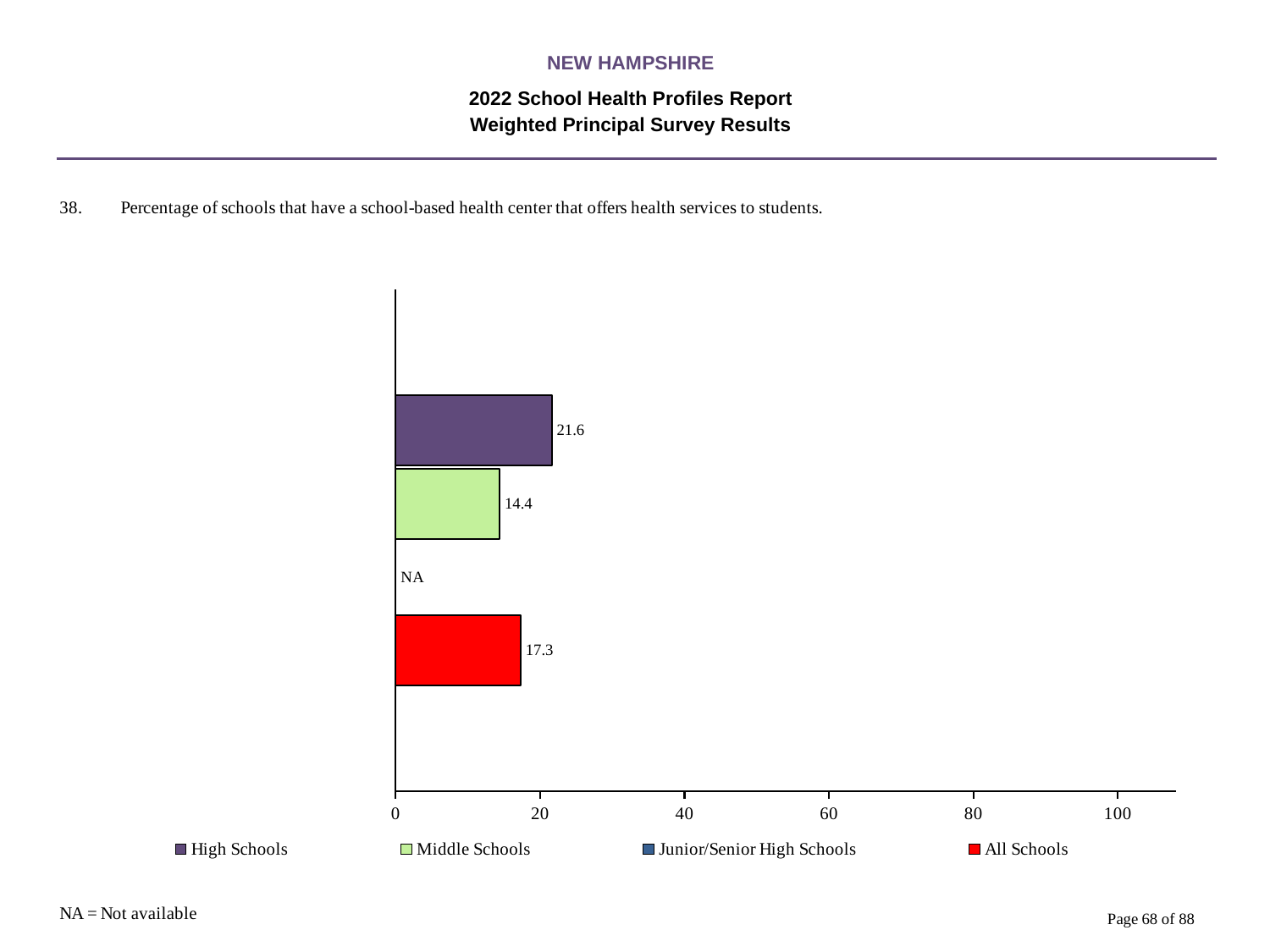
What is shown for Junior/Senior High Schools? NA What is the difference between the All Schools and Middle Schools values? 2.9 Is the value for High Schools greater or less than 20? greater Which series has the highest value? High Schools What is the value for All Schools? 17.3 What is the difference between the High Schools and Middle Schools values? 7.2 Which is larger, the value for High Schools or the value for All Schools? High Schools What kind of chart is shown? Bar chart Which series with a plotted bar has the lowest value? Middle Schools What is the value for High Schools? 21.6 How many series does the legend list? 4 What is the value for Middle Schools? 14.4